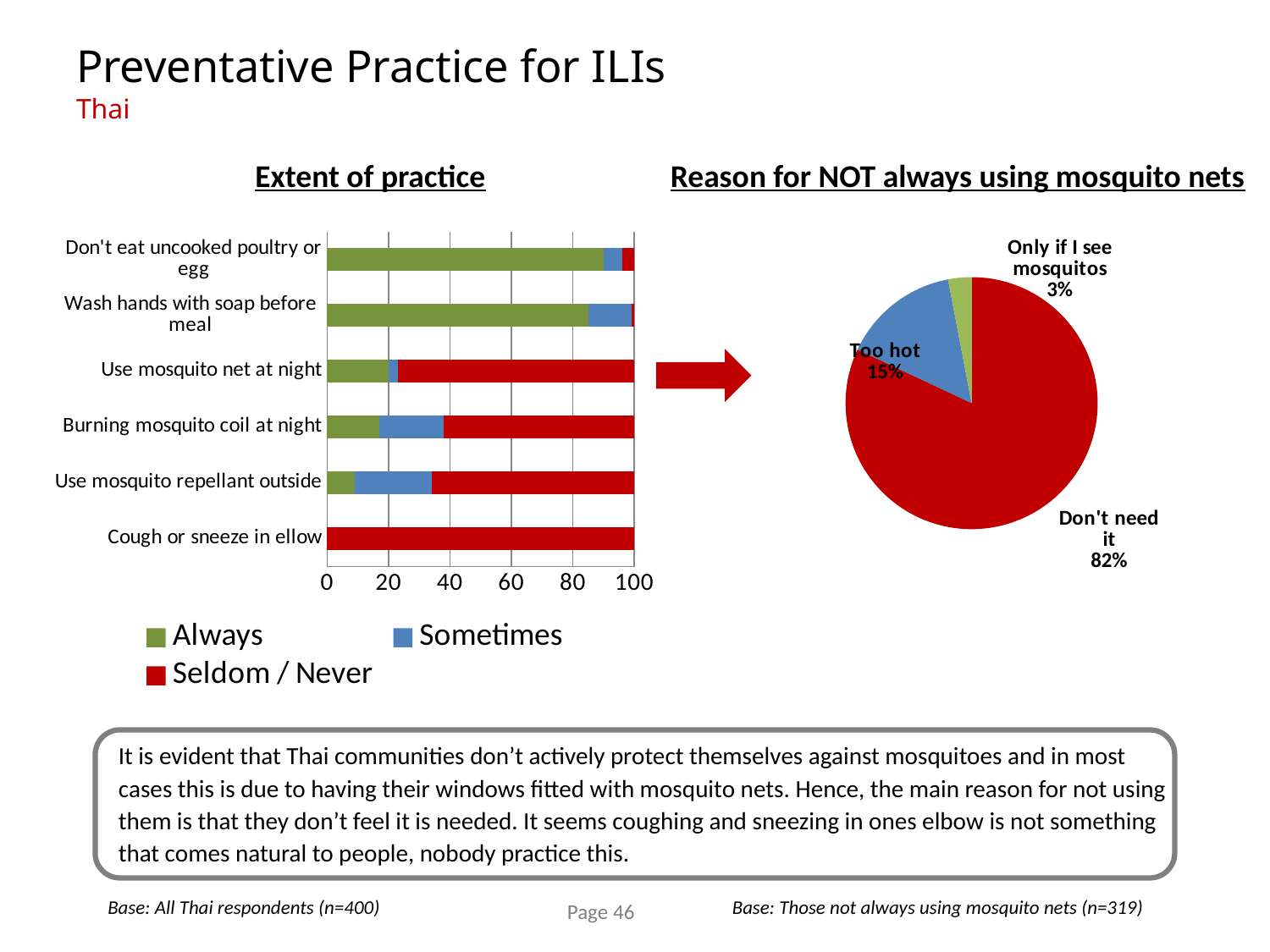
In the pie chart 'Reason for NOT always using mosquito nets', which reason has the smallest share? Only if I see mosquitos In the pie chart 'Reason for NOT always using mosquito nets', how many percentage points larger is 'Don't need it' than 'Too hot'? 67 percentage points In the 'Extent of practice' chart, how many practices (categories) are listed? 6 In the pie chart 'Reason for NOT always using mosquito nets', what percentage is shown for 'Don't need it'? 82% In the pie chart 'Reason for NOT always using mosquito nets', what percentage is shown for 'Only if I see mosquitos'? 3% In the pie chart 'Reason for NOT always using mosquito nets', which reason has the largest share? Don't need it In the pie chart 'Reason for NOT always using mosquito nets', how many slices are there? 3 In the 'Extent of practice' chart, which has a larger 'Always' value: 'Wash hands with soap before meal' or 'Use mosquito net at night'? Wash hands with soap before meal In the 'Extent of practice' chart, is the 'Always' value for 'Don't eat uncooked poultry or egg' greater or less than 80? greater What type of chart is the 'Extent of practice' chart? Bar chart In the 'Extent of practice' chart, how many series does the legend list? 3 In the pie chart 'Reason for NOT always using mosquito nets', what percentage is shown for 'Too hot'? 15%